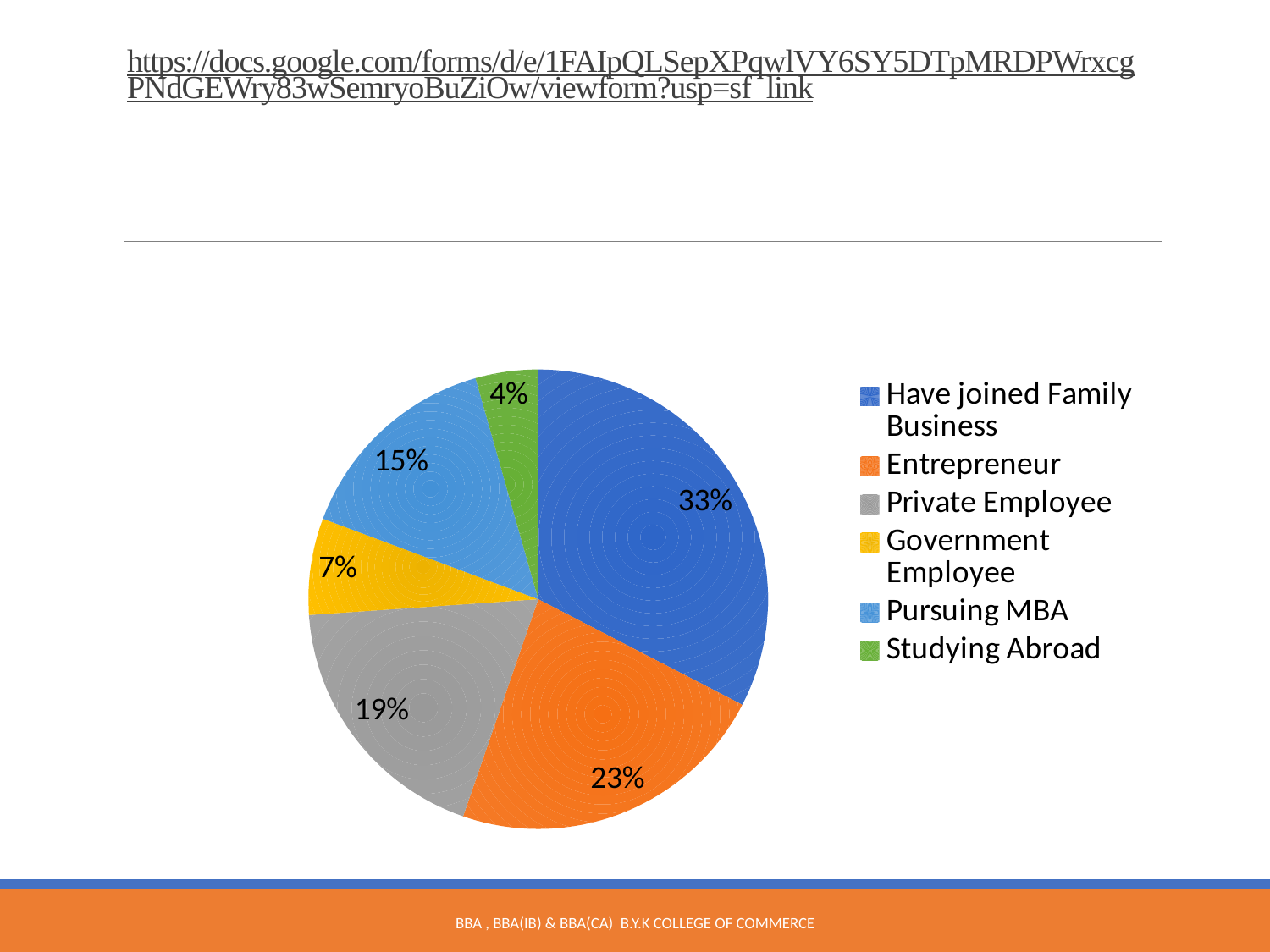
What percentage is shown for Pursuing MBA? 15% Which category has the smallest slice of the pie? Studying Abroad What percentage is shown for Entrepreneur? 23% What percentage is shown for Studying Abroad? 4% What share of the pie is labelled for Have joined Family Business? 33% What percentage is shown for Private Employee? 19% Which category has the largest slice of the pie? Have joined Family Business What is the difference in percentage points between Entrepreneur and Pursuing MBA? 8 What percentage is shown for Government Employee? 7% How many categories does the legend list? 6 Which is larger, the slice for Private Employee or the slice for Government Employee? Private Employee What kind of chart is shown on the slide? pie chart